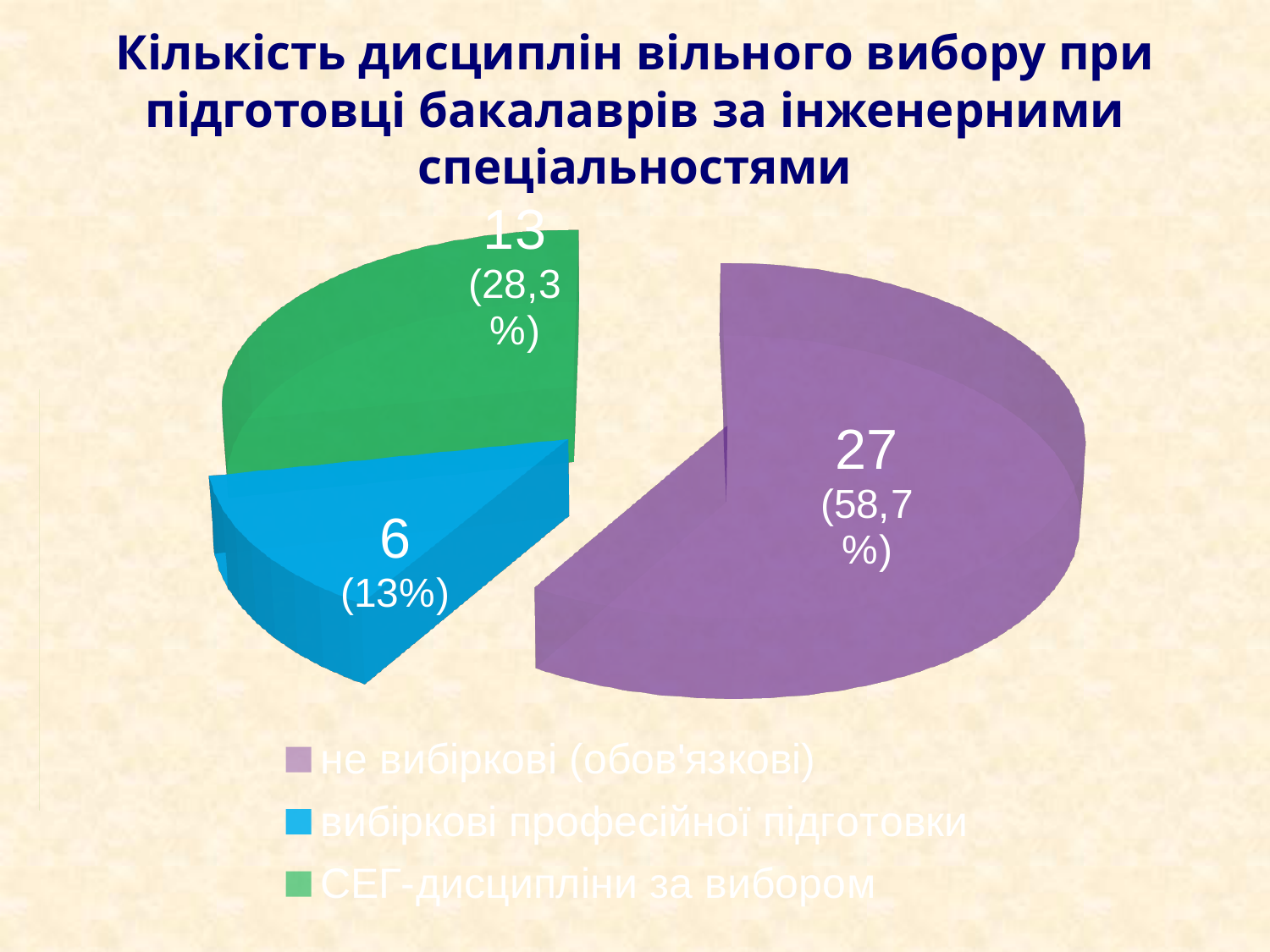
How many slices does the pie chart have? 3 What share of the pie does "СЕГ-дисципліни за вибором" take? 28,3% What share of the pie does "не вибіркові (обов'язкові)" take? 58,7% Which category has the largest slice? не вибіркові (обов'язкові) What kind of chart is shown on the slide? pie chart What is the difference between the values for "не вибіркові (обов'язкові)" and "СЕГ-дисципліни за вибором"? 14 How many entries does the legend list? 3 What is the value for "не вибіркові (обов'язкові)"? 27 What is the value for "вибіркові професійної підготовки"? 6 Which category has the smallest slice? вибіркові професійної підготовки What is the value for "СЕГ-дисципліни за вибором"? 13 Which colour represents "СЕГ-дисципліни за вибором" in the chart? green